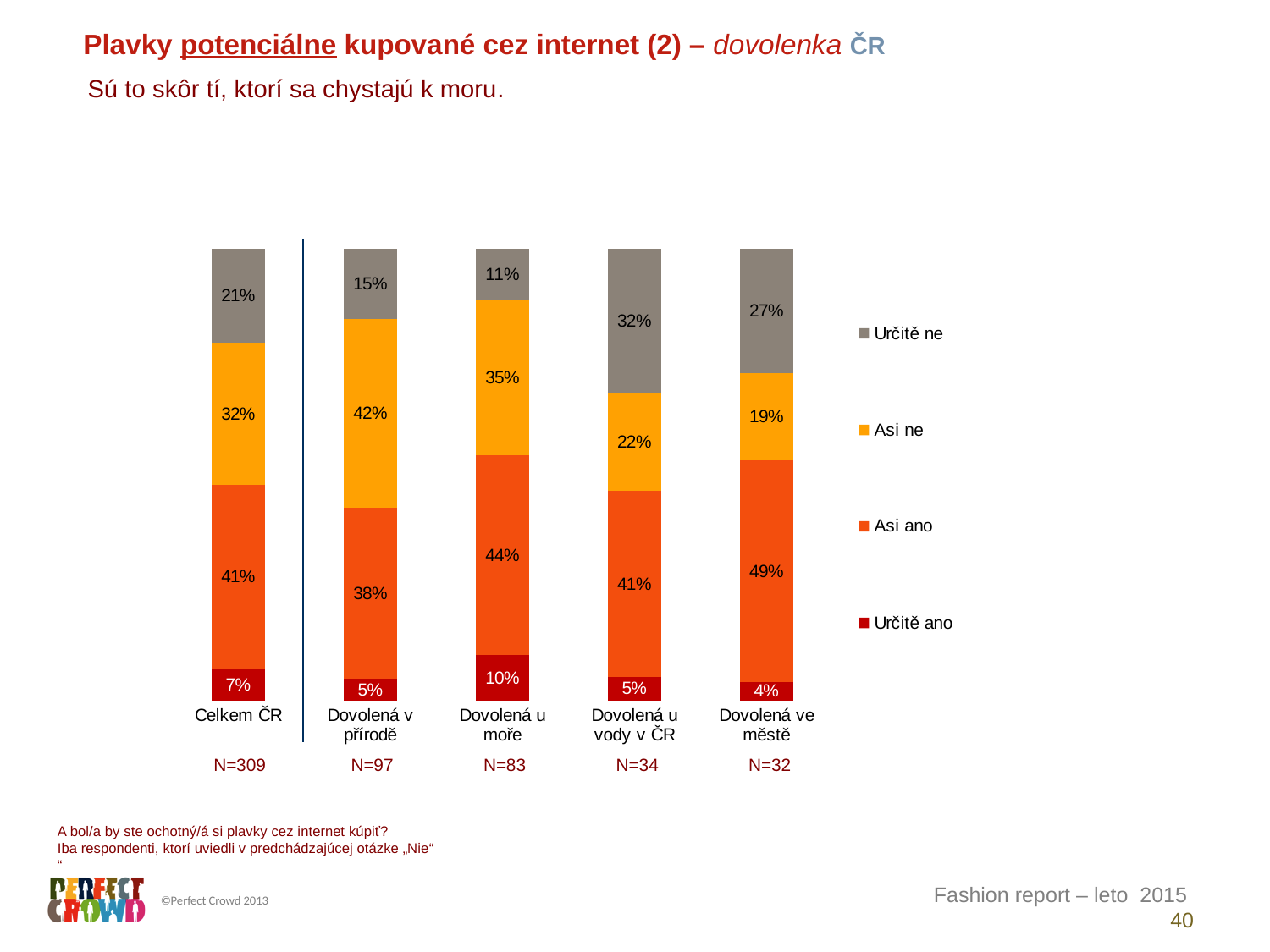
Which category has the lowest value for "Určitě ne"? Dovolená u moře What is the value for "Určitě ano" in the "Celkem ČR" category? 7% What is the sample size (N) shown for the "Dovolená u moře" category? N=83 How many series does the legend list? 4 Which is larger: the "Asi ne" value for "Celkem ČR" or for "Dovolená ve městě"? Celkem ČR What is the value for "Asi ne" in the "Dovolená v přírodě" category? 42% What is the value for "Asi ano" in the "Dovolená u moře" category? 44% How many categories are shown on the x axis? 5 What kind of chart is shown on the slide? Stacked bar chart Which category has the highest value for "Určitě ano"? Dovolená u moře What is the value for "Určitě ne" in the "Dovolená u vody v ČR" category? 32% What is the difference between the "Asi ano" values for "Dovolená ve městě" and "Dovolená v přírodě"? 11%